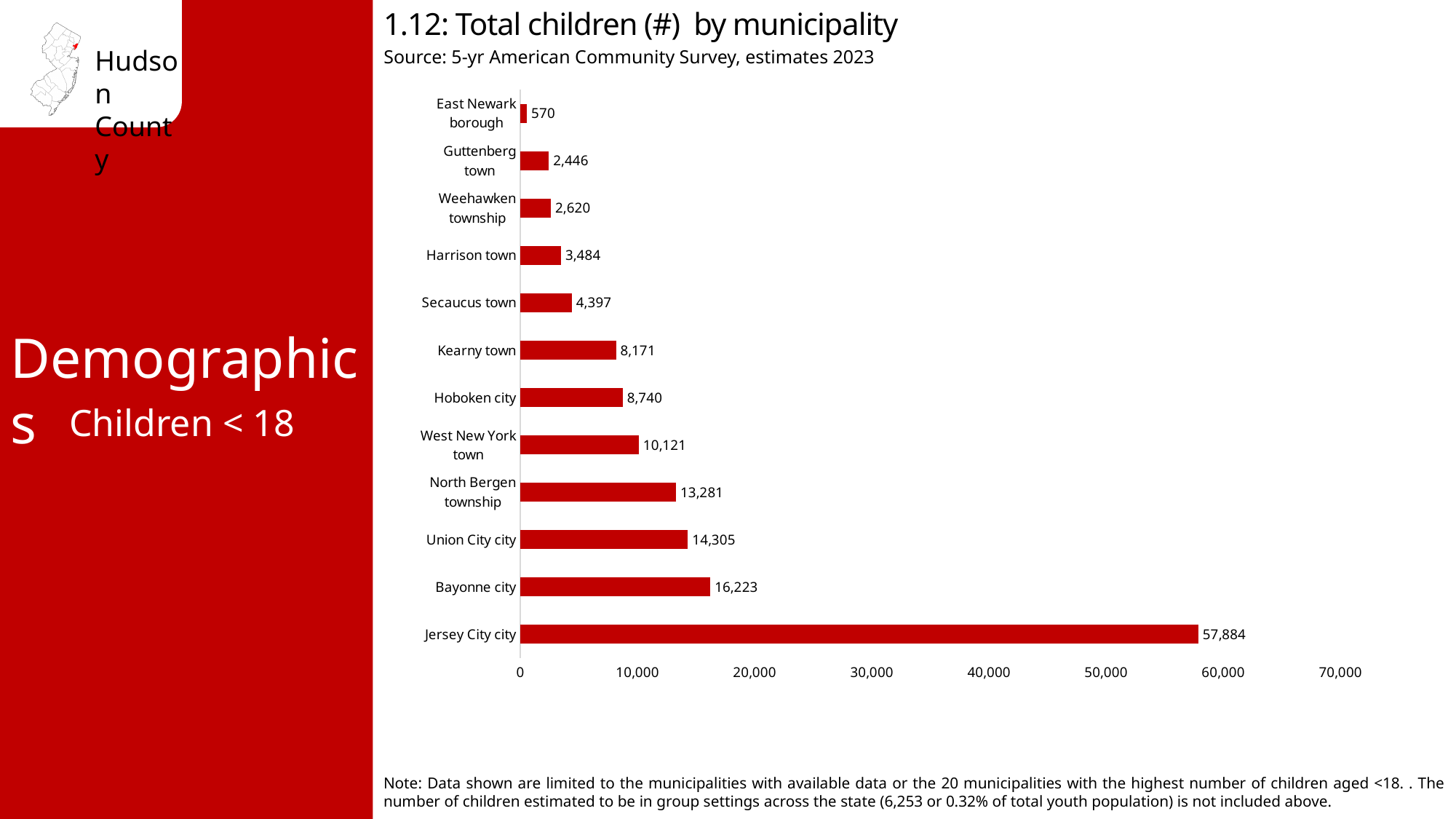
Which municipality has the lowest number of children? East Newark borough What is the total number of children for Jersey City city? 57,884 What kind of chart is shown on the slide? bar chart What is the total number of children for Hoboken city? 8,740 Which has more children, Kearny town or Secaucus town? Kearny town How many municipalities are shown in the chart? 12 What is the total number of children for North Bergen township? 13,281 Is the value for West New York town greater or less than 10,000? greater What is the source of the data shown in the chart? 5-yr American Community Survey, estimates 2023 Which municipality has the highest number of children? Jersey City city What is the difference in the number of children between Bayonne city and Union City city? 1,918 What is the title of the chart? 1.12: Total children (#) by municipality